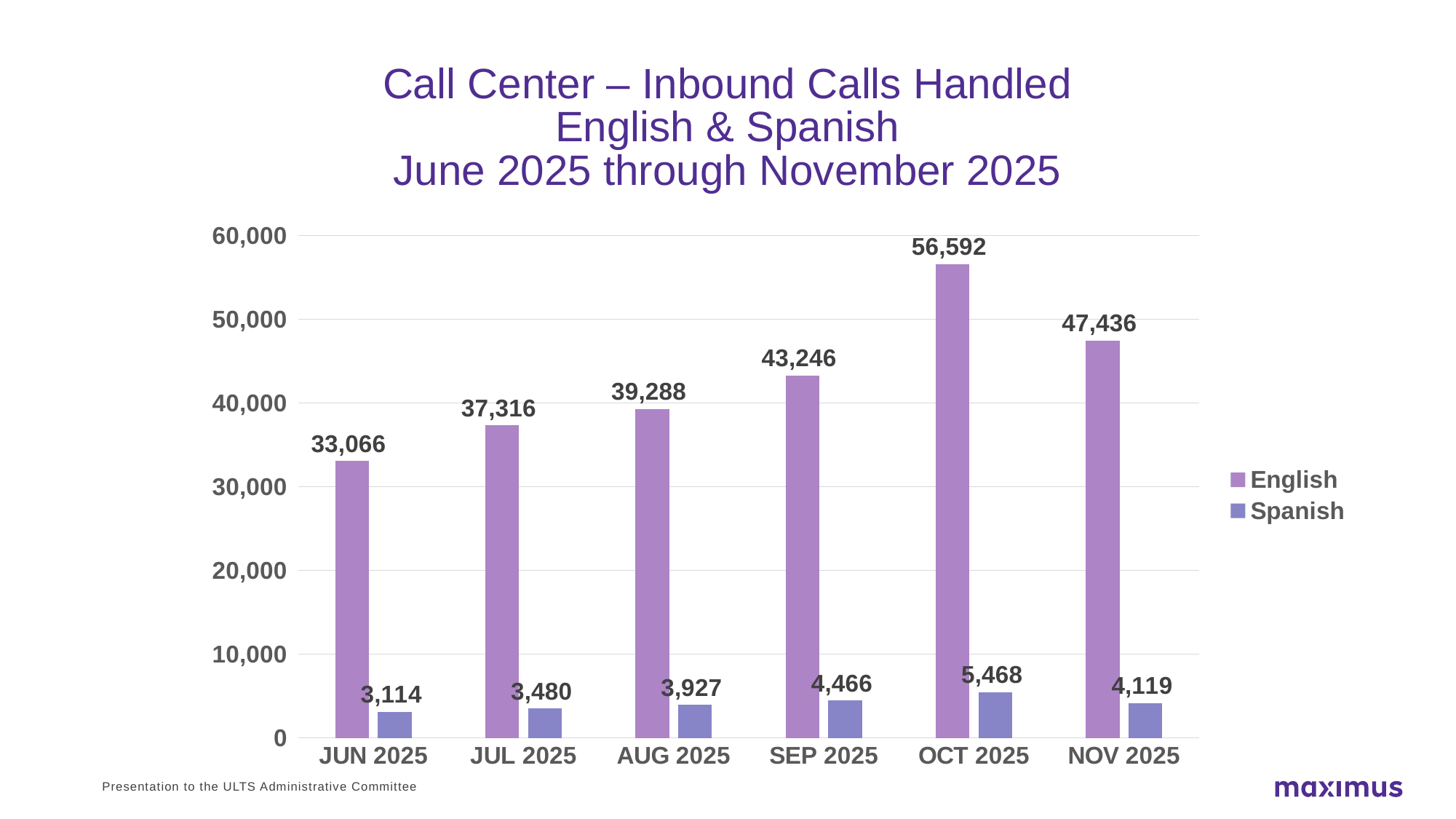
How many English inbound calls were handled in OCT 2025? 56,592 How many series does the legend list? 2 Is the value for English calls in AUG 2025 greater or less than 40,000? less Which month had the lowest number of Spanish calls handled? JUN 2025 Do English calls handled rise or fall from JUN 2025 to OCT 2025? rise What kind of chart is shown on the slide? bar chart What is the difference between English calls handled in OCT 2025 and NOV 2025? 9,156 How many Spanish inbound calls were handled in JUL 2025? 3,480 How many months are shown on the x axis? 6 Which month had the highest number of English calls handled? OCT 2025 What is the total of English and Spanish calls handled in SEP 2025? 47,712 Which is larger: Spanish calls in SEP 2025 or Spanish calls in NOV 2025? SEP 2025